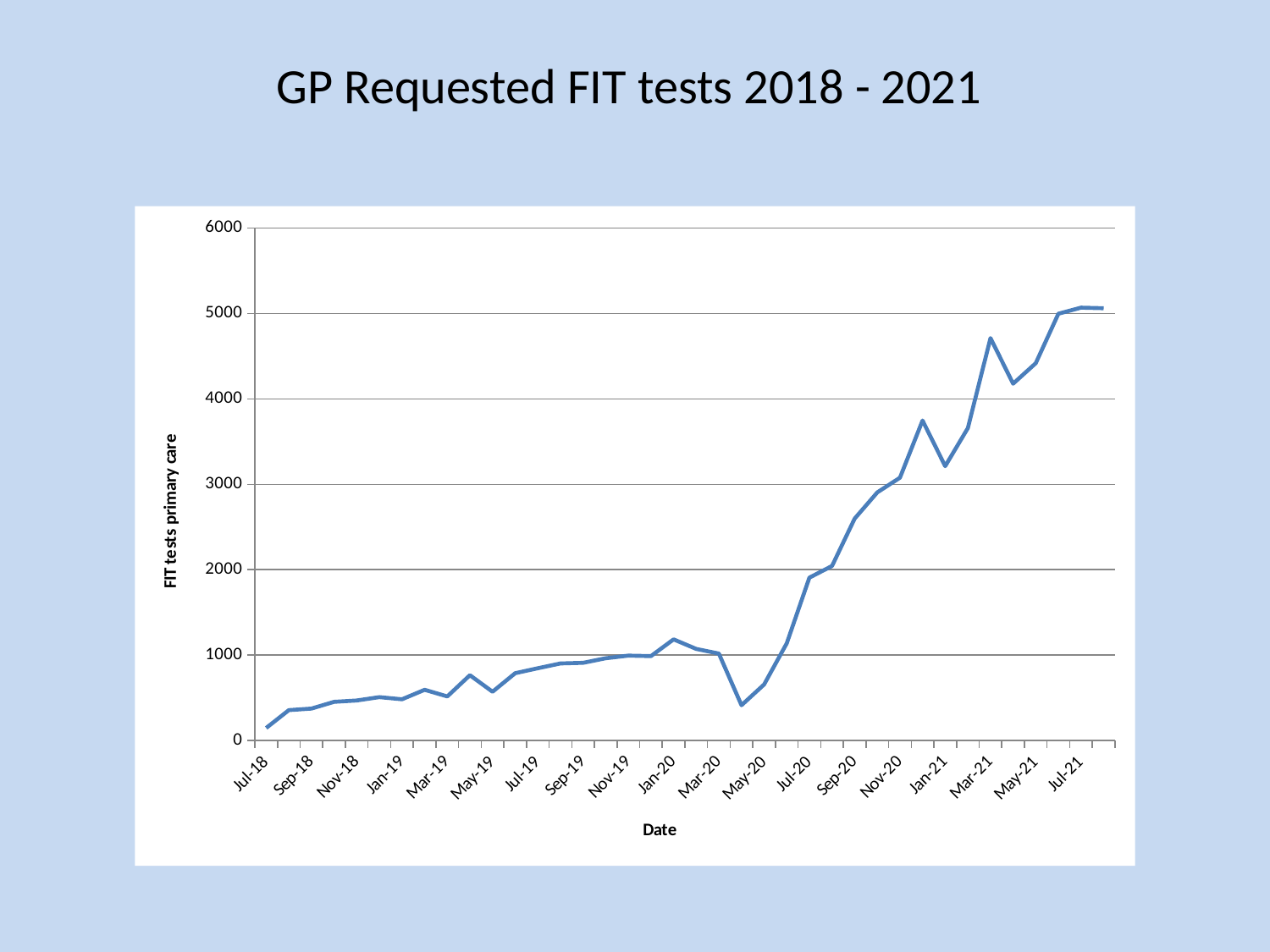
Is the value for May-20 greater or less than 1000? less Is the value for Jan-21 greater or less than 3000? greater Is the value for Jul-18 greater or less than 1000? less What is the title of the chart? GP Requested FIT tests 2018 - 2021 Which month has the lowest value on the chart? Jul-18 What kind of chart is shown on the slide? line chart Overall, do the values rise or fall from Jul-18 to Jul-21? rise What is the label of the vertical axis? FIT tests primary care How many lines are plotted on the chart? 1 Which is larger, the value for Jan-20 or the value for Jan-21? Jan-21